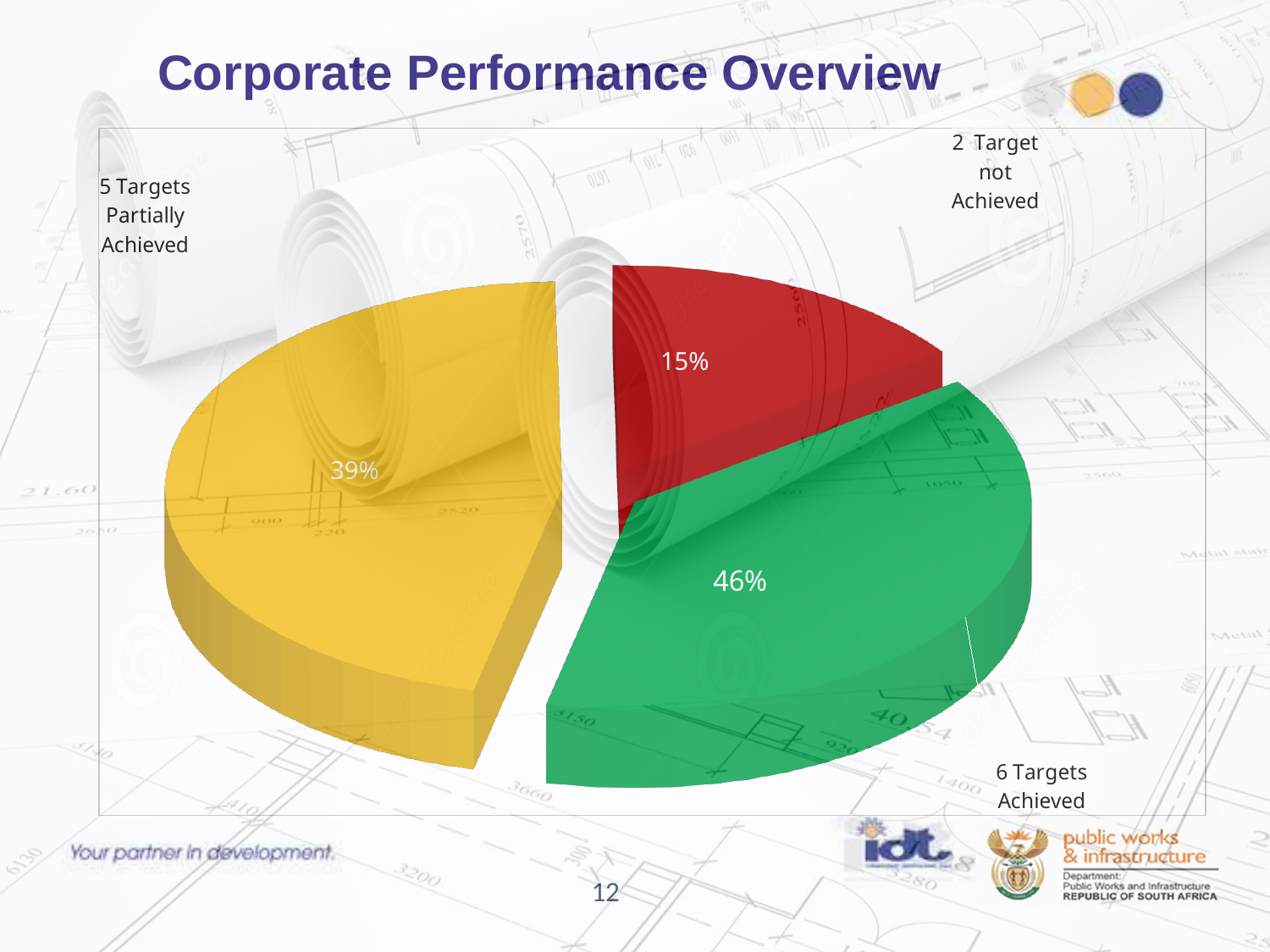
Which slice of the pie is the smallest? 2 Target not Achieved What percentage of the pie is labelled "6 Targets Achieved"? 46% What kind of chart is shown on the slide? Pie chart What is the difference in percentage points between the "6 Targets Achieved" slice and the "2 Target not Achieved" slice? 31 percentage points Which is larger: the "5 Targets Partially Achieved" slice or the "2 Target not Achieved" slice? 5 Targets Partially Achieved What percentage of the pie is labelled "2 Target not Achieved"? 15% How many slices does the pie chart have? 3 What colour is the "6 Targets Achieved" slice of the pie? Green Which slice of the pie is the largest? 6 Targets Achieved What is the title of the slide containing the pie chart? Corporate Performance Overview What is the difference in percentage points between the "6 Targets Achieved" slice and the "5 Targets Partially Achieved" slice? 7 percentage points What percentage of the pie is labelled "5 Targets Partially Achieved"? 39%